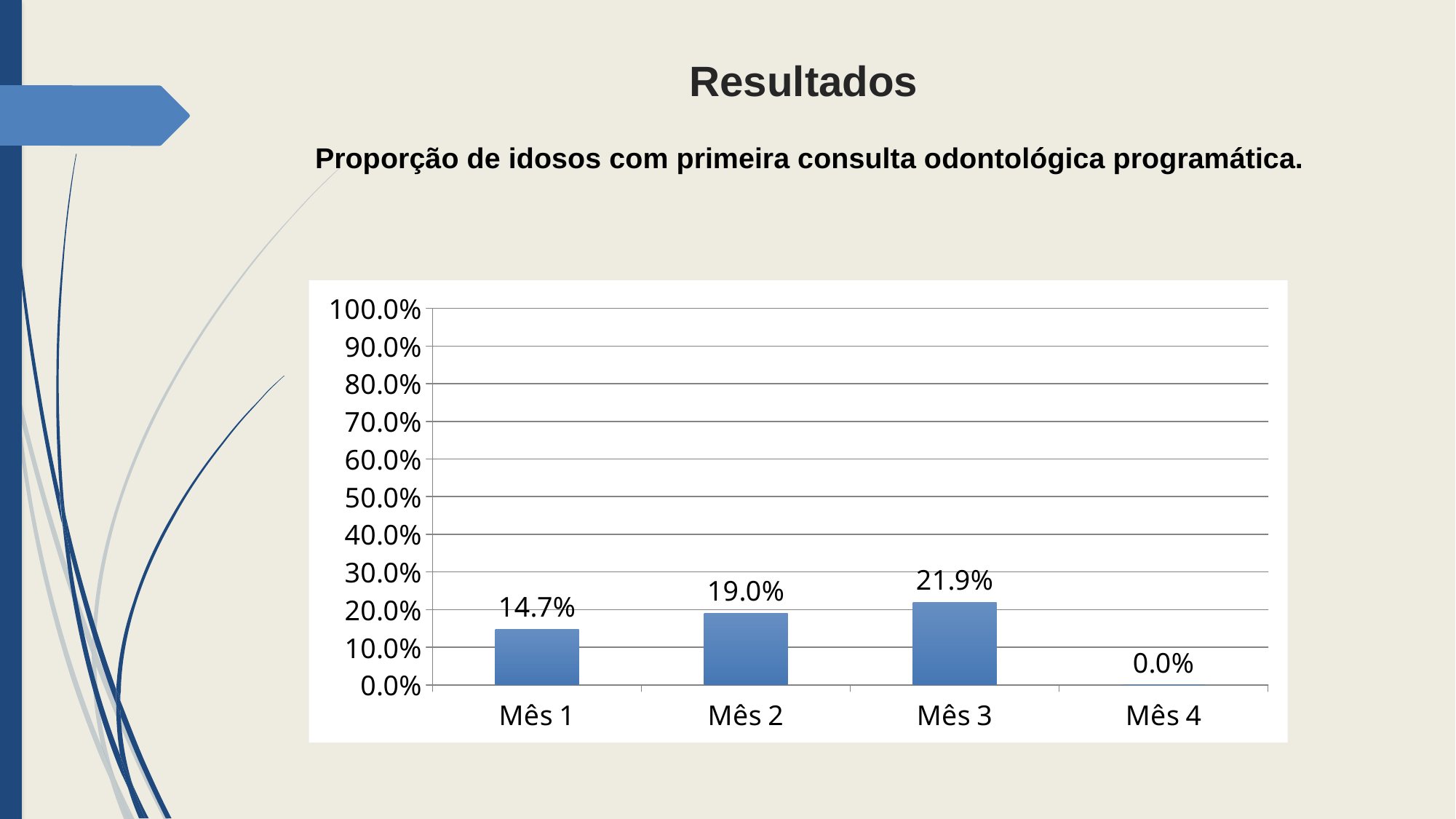
What is the difference between the values for Mês 3 and Mês 1? 7.2% What is the title of the chart on the slide? Proporção de idosos com primeira consulta odontológica programática. Which month has the lowest value? Mês 4 Is the value for Mês 3 greater or less than 30.0%? less How many months are shown on the x axis? 4 Which is larger, the value for Mês 2 or the value for Mês 1? Mês 2 What is the value for Mês 4? 0.0% Which month has the highest value? Mês 3 What is the value for Mês 3? 21.9% What kind of chart is shown on the slide? bar chart What is the value for Mês 2? 19.0% What is the value for Mês 1? 14.7%